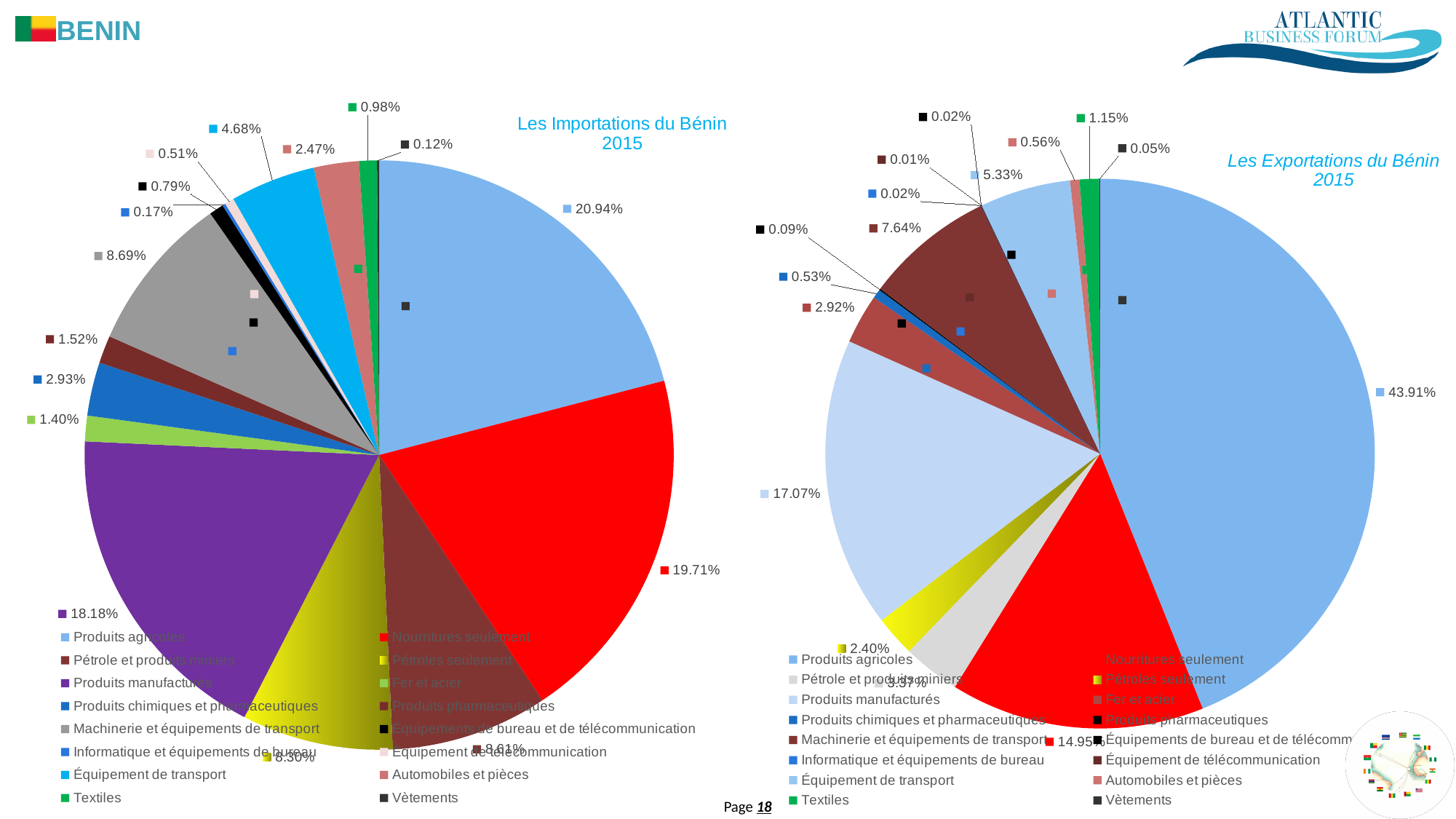
In 'Les Exportations du Bénin 2015', what share do Produits agricoles have? 43.91% What is the title of the pie chart on the right of the slide? Les Exportations du Bénin 2015 In 'Les Exportations du Bénin 2015', which category has the largest share? Produits agricoles In 'Les Importations du Bénin 2015', what share do Produits manufacturés have? 18.18% In 'Les Exportations du Bénin 2015', what share do Produits manufacturés have? 17.07% In 'Les Exportations du Bénin 2015', what is the difference between Produits manufacturés and Nourritures seulement? 2.12% In 'Les Importations du Bénin 2015', which is larger: Machinerie et équipements de transport or Équipement de transport? Machinerie et équipements de transport In 'Les Importations du Bénin 2015', what share do Produits agricoles have? 20.94% How many categories does the legend of 'Les Exportations du Bénin 2015' list? 16 In 'Les Importations du Bénin 2015', which category has the largest share? Produits agricoles What kind of chart is 'Les Importations du Bénin 2015'? Pie chart In 'Les Importations du Bénin 2015', what is the difference between Produits agricoles and Nourritures seulement? 1.23%